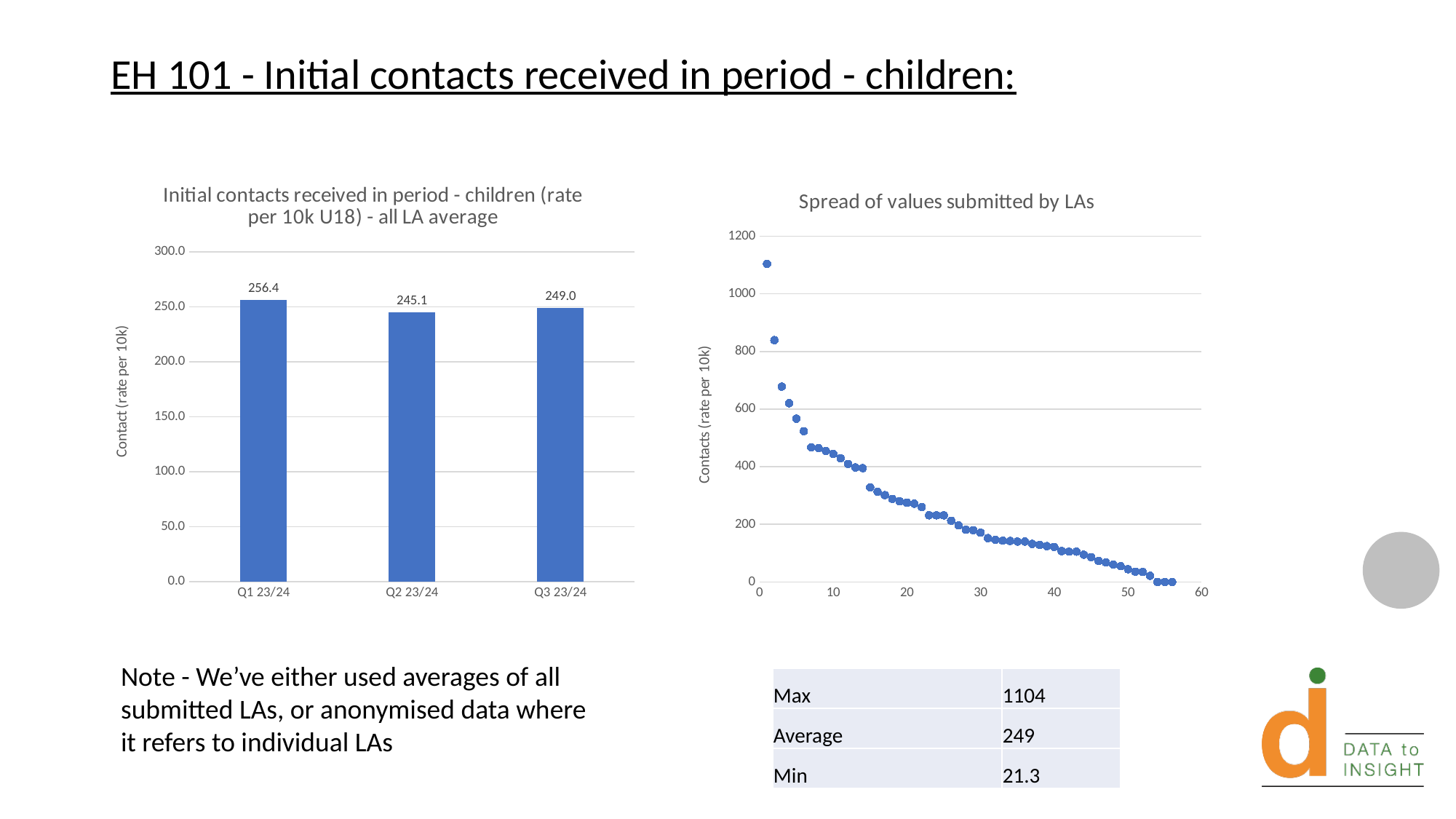
In the right chart, 'Spread of values submitted by LAs', do the values rise or fall along the x axis? Fall What kind of chart is the left chart (all LA average)? Bar chart In the left chart (all LA average), what is the value for Q2 23/24? 245.1 In the left chart (all LA average), what is the value for Q3 23/24? 249.0 In the left chart (all LA average), what is the difference between the Q1 23/24 and Q2 23/24 values? 11.3 What kind of chart is the right chart, 'Spread of values submitted by LAs'? Scatter chart In the left chart (all LA average), what is the value for Q1 23/24? 256.4 In the right chart, 'Spread of values submitted by LAs', is the highest plotted value greater or less than 1000? greater In the left chart (all LA average), which quarter has the highest value? Q1 23/24 In the left chart (all LA average), how many quarters are plotted? 3 In the left chart (all LA average), which is larger, the value for Q3 23/24 or Q2 23/24? Q3 23/24 In the left chart (all LA average), which quarter has the lowest value? Q2 23/24